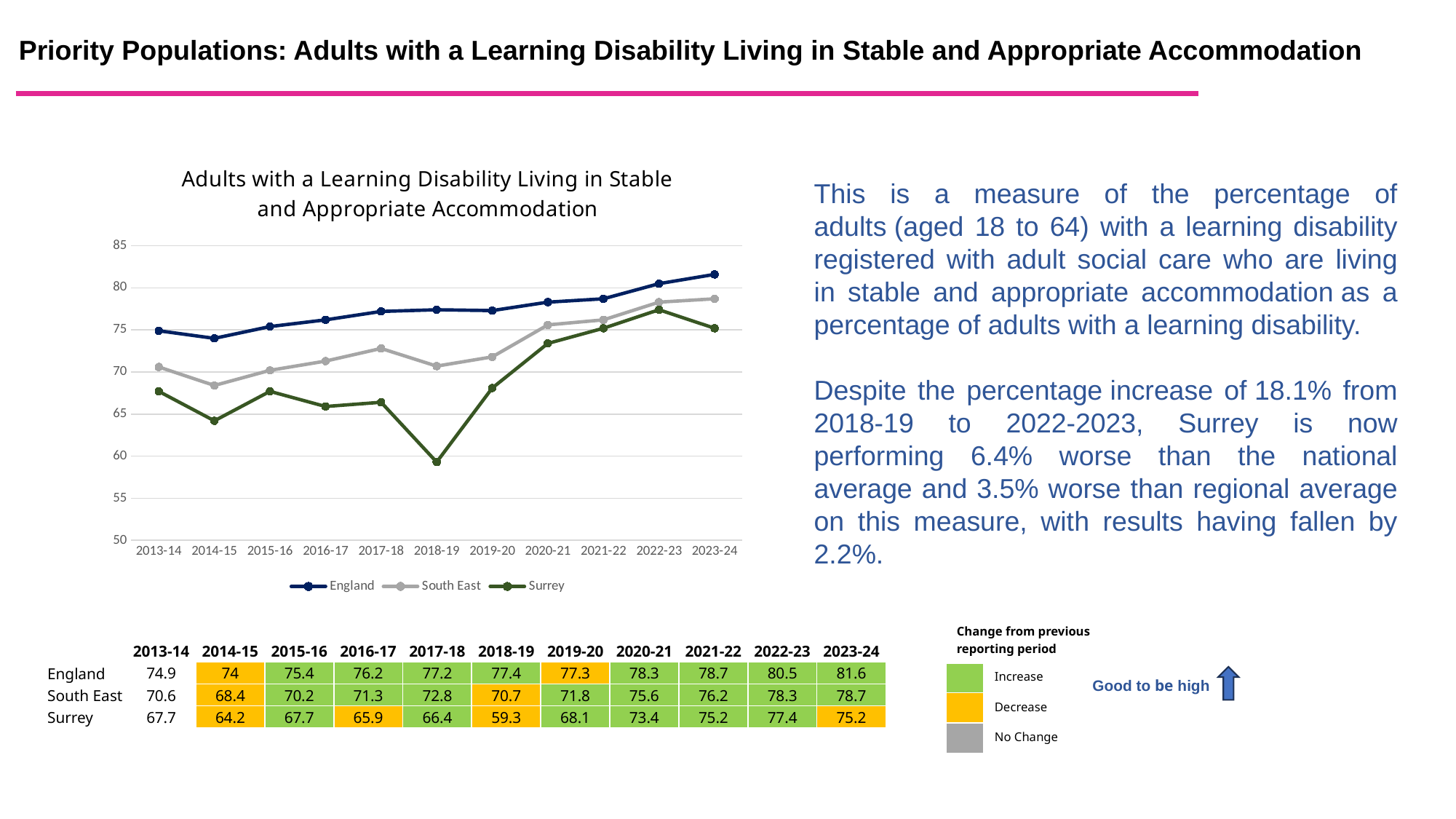
Does the England series generally rise or fall from 2014-15 to 2023-24? rise What type of chart is shown on the slide? line chart What is the value for South East in 2020-21? 75.6 How many series does the chart legend list? 3 Which series has the higher value in 2022-23, South East or Surrey? South East In which reporting period is the Surrey value lowest? 2018-19 In which reporting period is the England value highest? 2023-24 What is the value for Surrey in 2018-19? 59.3 Is the Surrey value for 2018-19 greater or less than 60? less What is the value for England in 2023-24? 81.6 How many reporting periods are plotted along the x axis of the chart? 11 What is the difference between the England and Surrey values in 2023-24? 6.4